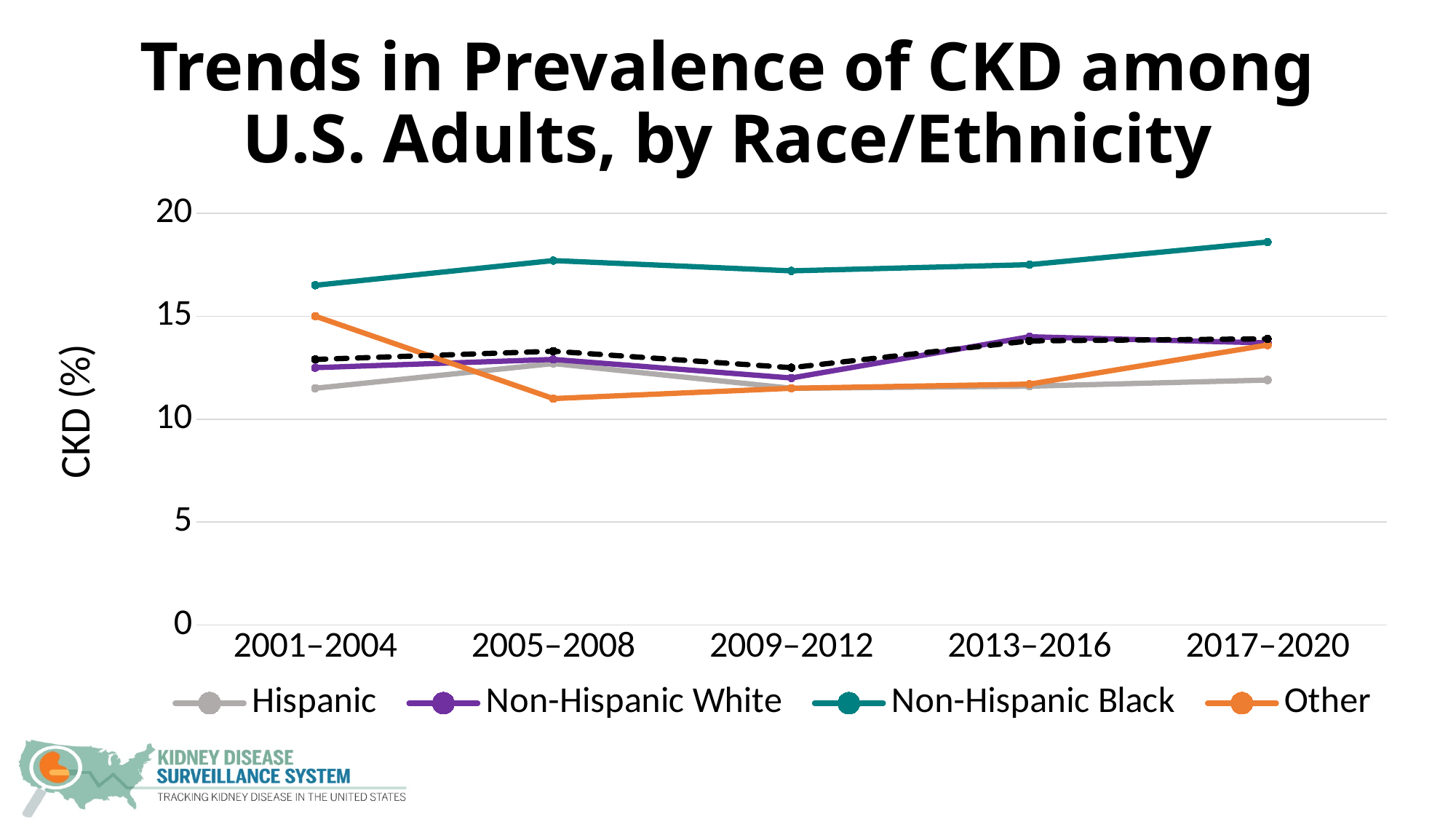
Is the value for Hispanic in 2001–2004 greater or less than 15? less How many series does the legend list? 4 What kind of chart is shown on the slide? Line chart How many time periods are shown on the x axis? 5 Is the value for Non-Hispanic Black in 2017–2020 greater or less than 20? less Is the value for Non-Hispanic Black in 2001–2004 greater or less than 15? greater Which is larger in 2001–2004, the value for Other or the value for Hispanic? Other Does the value for Other rise or fall from 2001–2004 to 2005–2008? fall Which group has the lowest CKD prevalence in 2005–2008? Other Which race/ethnicity group has the highest CKD prevalence in every period shown? Non-Hispanic Black What is the label on the y axis? CKD (%) Which is larger in 2005–2008, the value for Non-Hispanic White or the value for Other? Non-Hispanic White